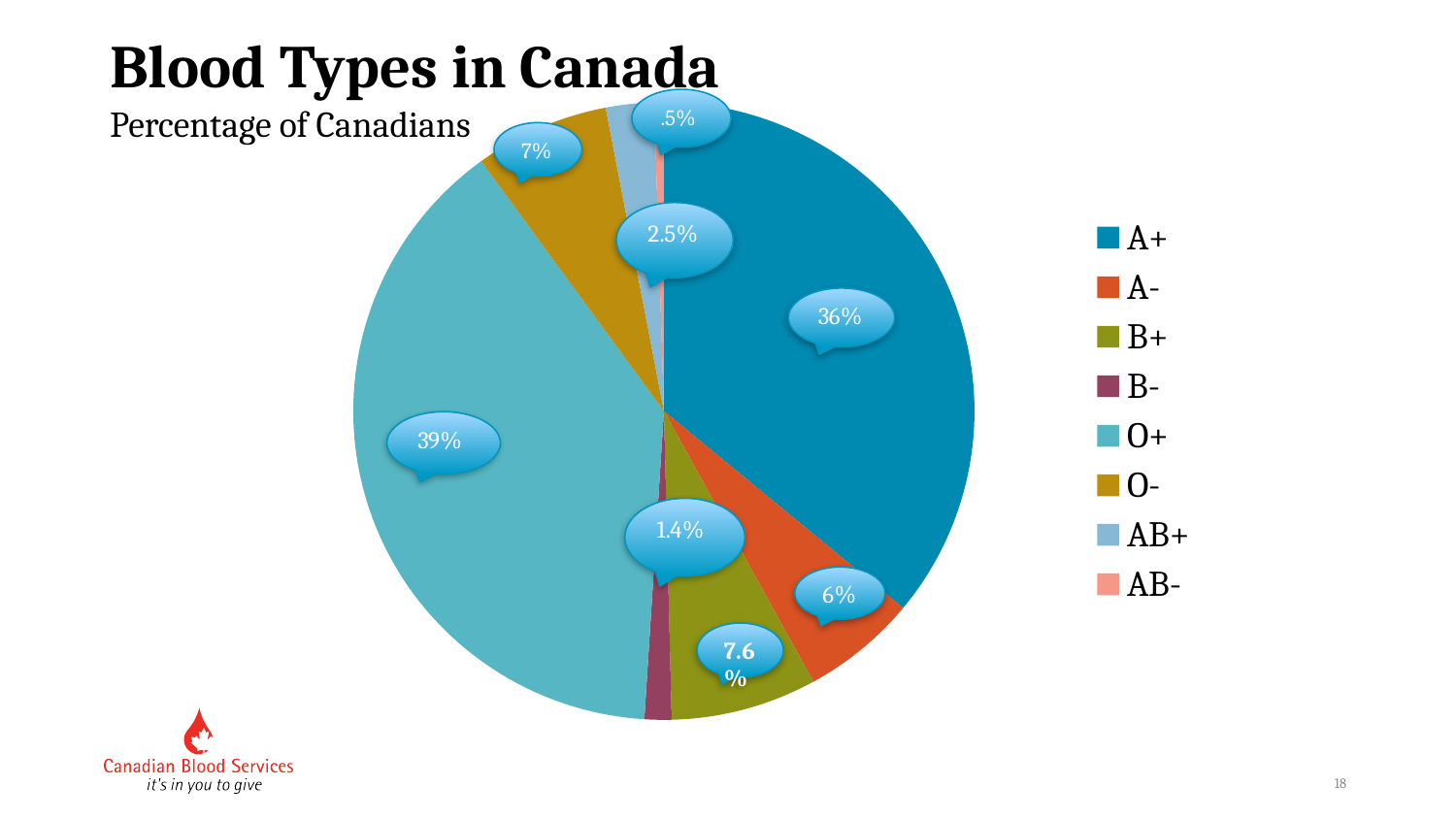
What percentage of Canadians have blood type B+? 7.6% Which blood type has the smallest share of the pie? AB- What percentage of Canadians have blood type O+? 39% Which is larger, the share for O- or the share for A-? O- How many blood types are listed in the legend? 8 Which blood type has the largest share of the pie? O+ What kind of chart is shown on the slide? pie chart What percentage of Canadians have blood type A+? 36% What is the difference in percentage points between O+ and A+? 3 What is the subtitle shown under the chart title? Percentage of Canadians What is the title of the chart? Blood Types in Canada What percentage of Canadians have blood type AB-? .5%